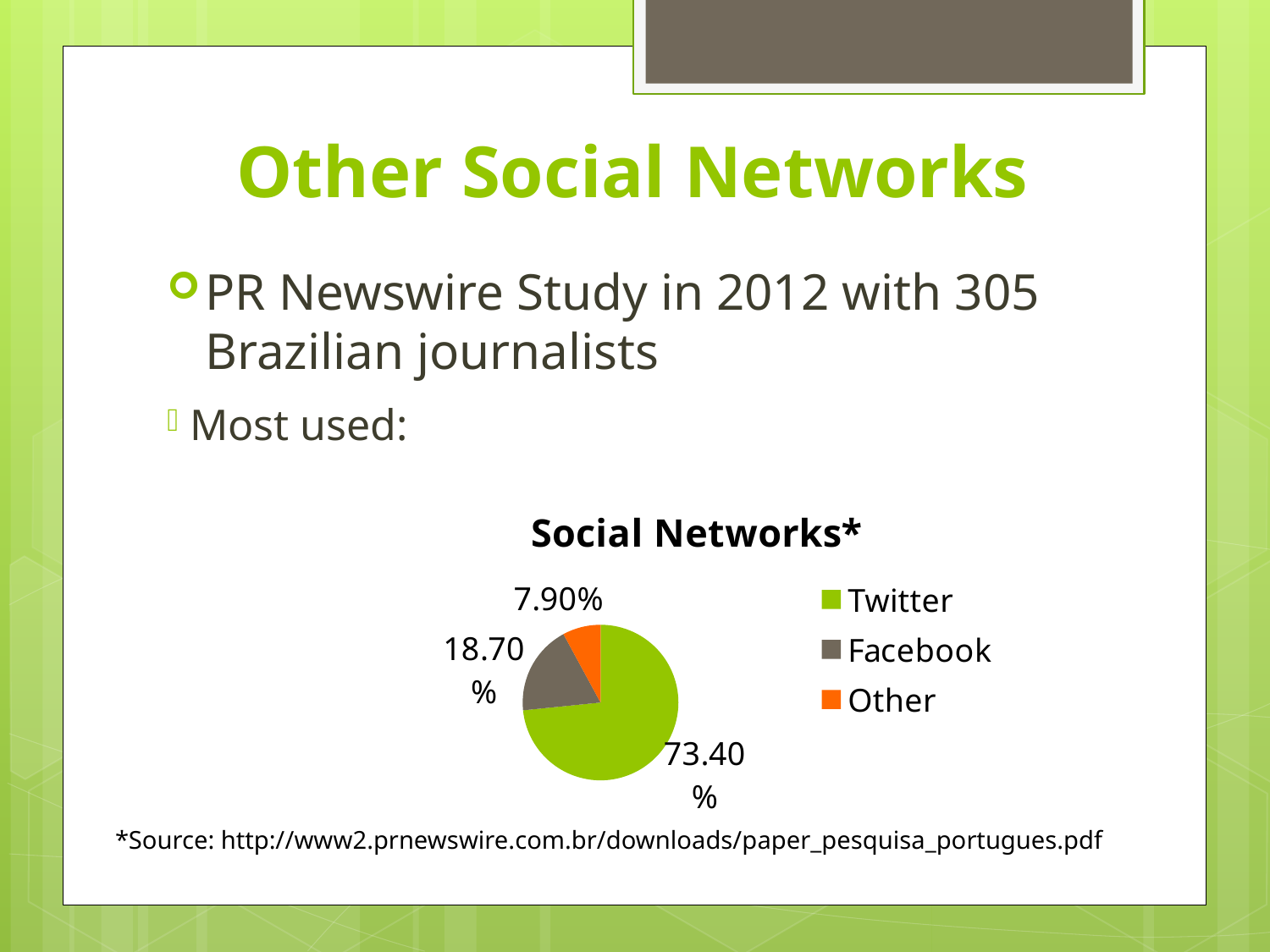
What share of the pie does Twitter have? 73.40% What share of the pie does Other have? 7.90% What is the title of the chart? Social Networks* What share of the pie does Facebook have? 18.70% Which is larger, the Facebook slice or the Other slice? Facebook What type of chart is shown on the slide? pie chart How many slices does the pie chart have? 3 What colour is the Other slice in the pie chart? orange Which category has the smallest slice of the pie? Other What is the difference in percentage points between Twitter and Facebook? 54.70 How many entries does the legend list? 3 Which social network has the largest slice of the pie? Twitter